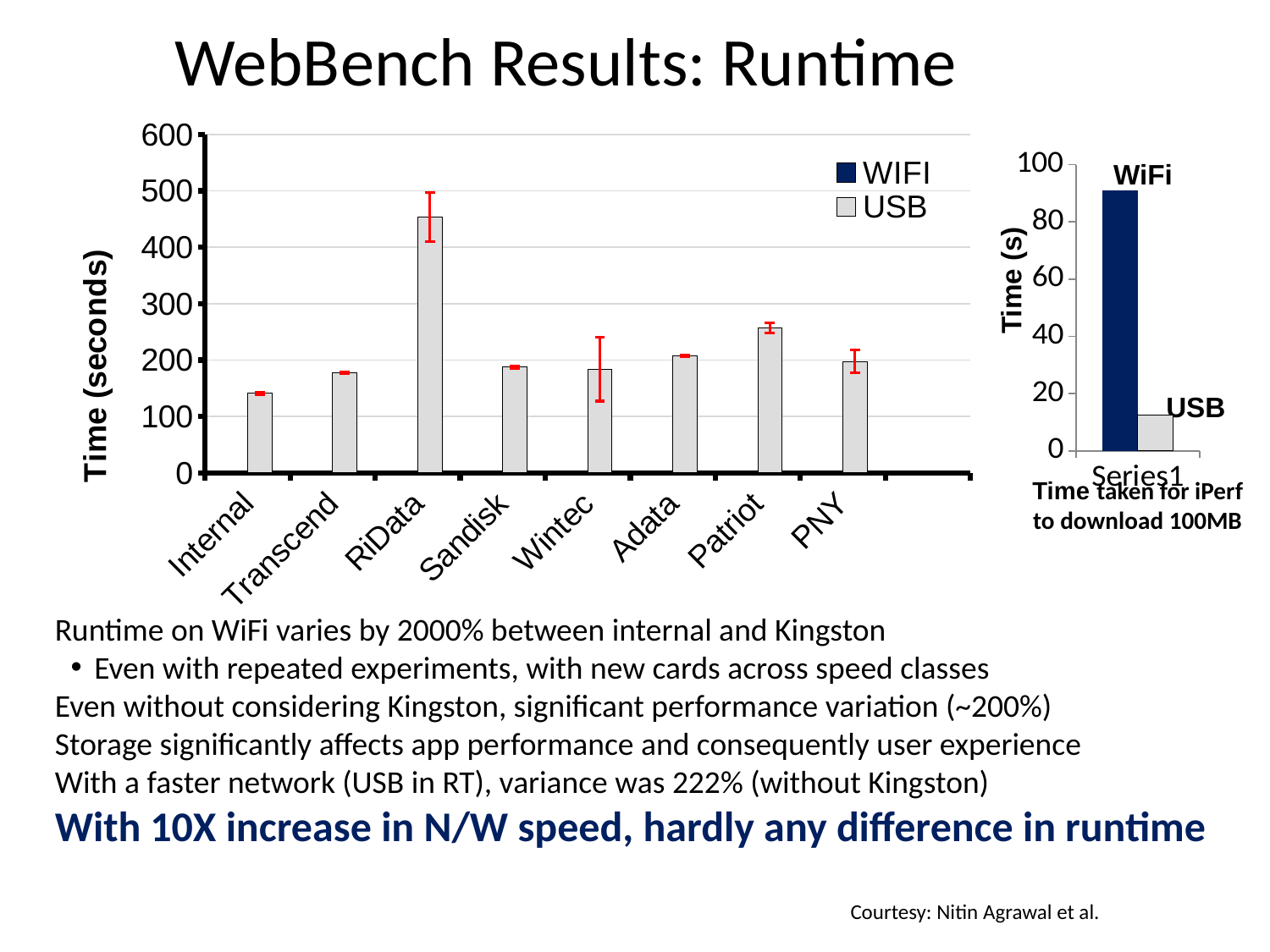
In the right chart (time taken for iPerf to download 100MB), which bar is taller, WiFi or USB? WiFi In the right chart (time taken for iPerf to download 100MB), is the value for USB greater or less than 20? less In the left chart, how many storage devices are listed on the x axis? 8 In the left chart (WebBench Results: Runtime), what kind of chart is shown? bar chart In the left chart, is the runtime for RiData greater or less than 400 seconds? greater In the left chart, which storage device has the lowest runtime? Internal In the left chart, which storage device has the highest runtime? RiData In the left chart, which has the larger runtime, Internal or Transcend? Transcend In the left chart, what is the label of the y axis? Time (seconds) In the left chart, how many series does the legend list? 2 In the left chart, is the runtime for Patriot greater or less than 200 seconds? greater